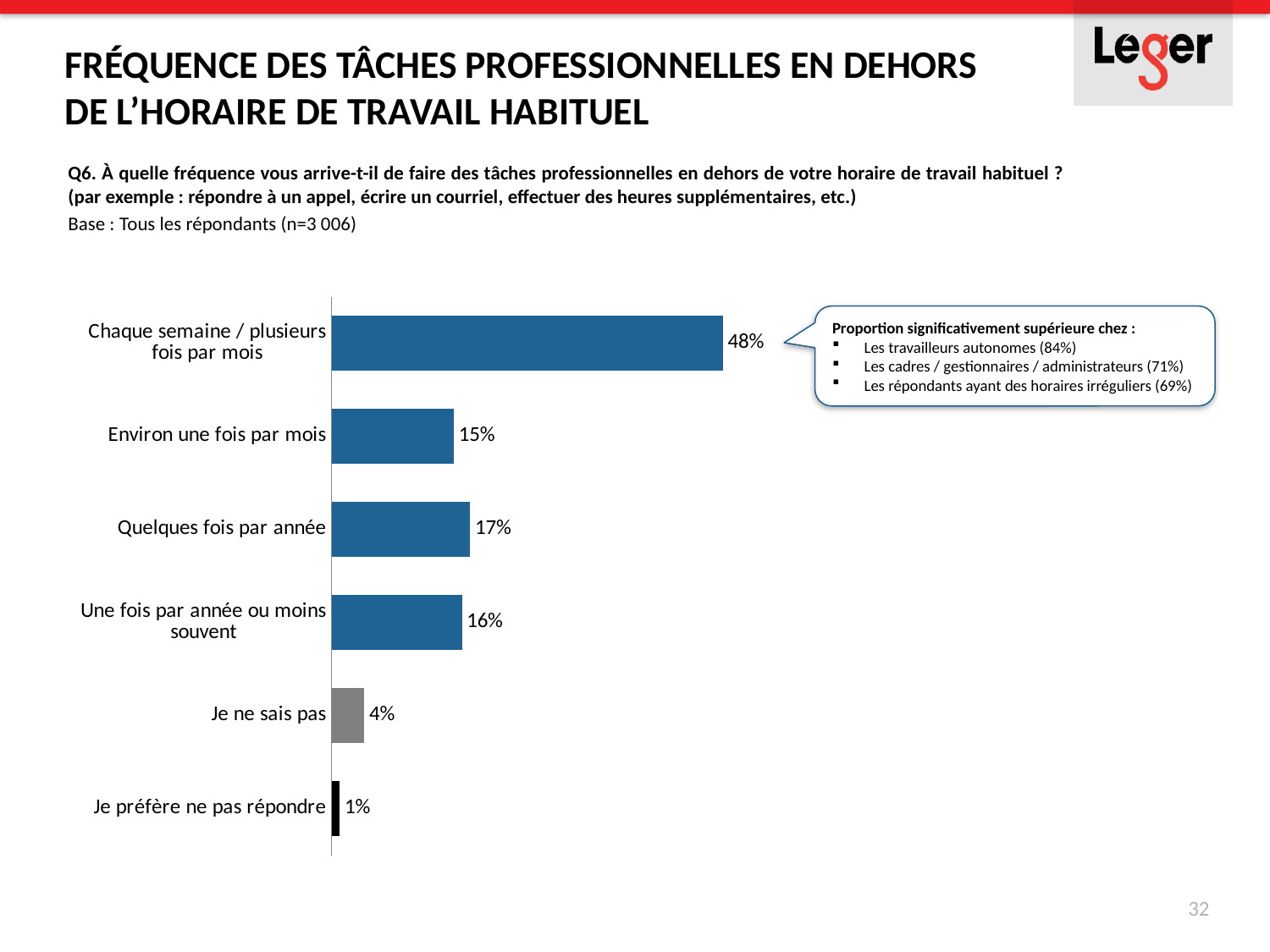
Which is larger: the value for "Quelques fois par année" or "Une fois par année ou moins souvent"? Quelques fois par année Which category has the lowest value? Je préfère ne pas répondre What is the value for "Quelques fois par année"? 17% What percentage of respondents answered "Je ne sais pas"? 4% What is the difference between the values for "Chaque semaine / plusieurs fois par mois" and "Environ une fois par mois"? 33% What percentage of respondents do professional tasks outside their usual work schedule every week / several times a month? 48% What is the value for "Une fois par année ou moins souvent"? 16% What kind of chart is shown on the slide? Bar chart How many categories are shown in the chart? 6 Which category has the highest value? Chaque semaine / plusieurs fois par mois What is the value for "Environ une fois par mois"? 15% According to the callout box, what is the proportion among self-employed workers (travailleurs autonomes)? 84%